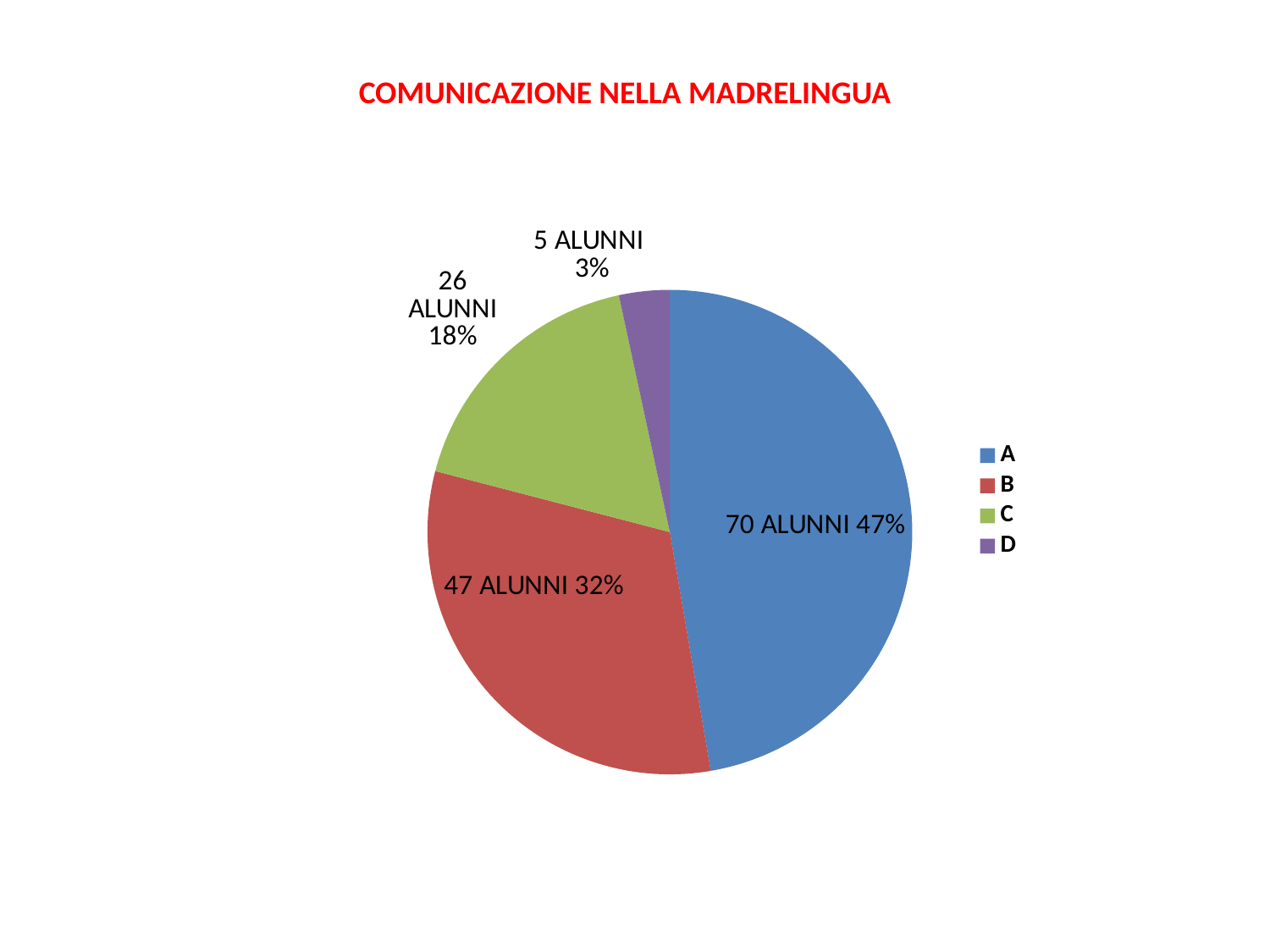
Which category has more alunni, C or D? C Which category has the smallest slice? D How many entries does the legend list? 4 How many more alunni are in category A than in category B? 23 What is the title of the chart? COMUNICAZIONE NELLA MADRELINGUA How many alunni are in category A? 70 ALUNNI What percentage share does category D have? 3% Which category has the largest slice? A What kind of chart is shown on the slide? pie chart How many slices does the pie chart have? 4 What percentage share does category B have? 32% How many alunni are in category C? 26 ALUNNI